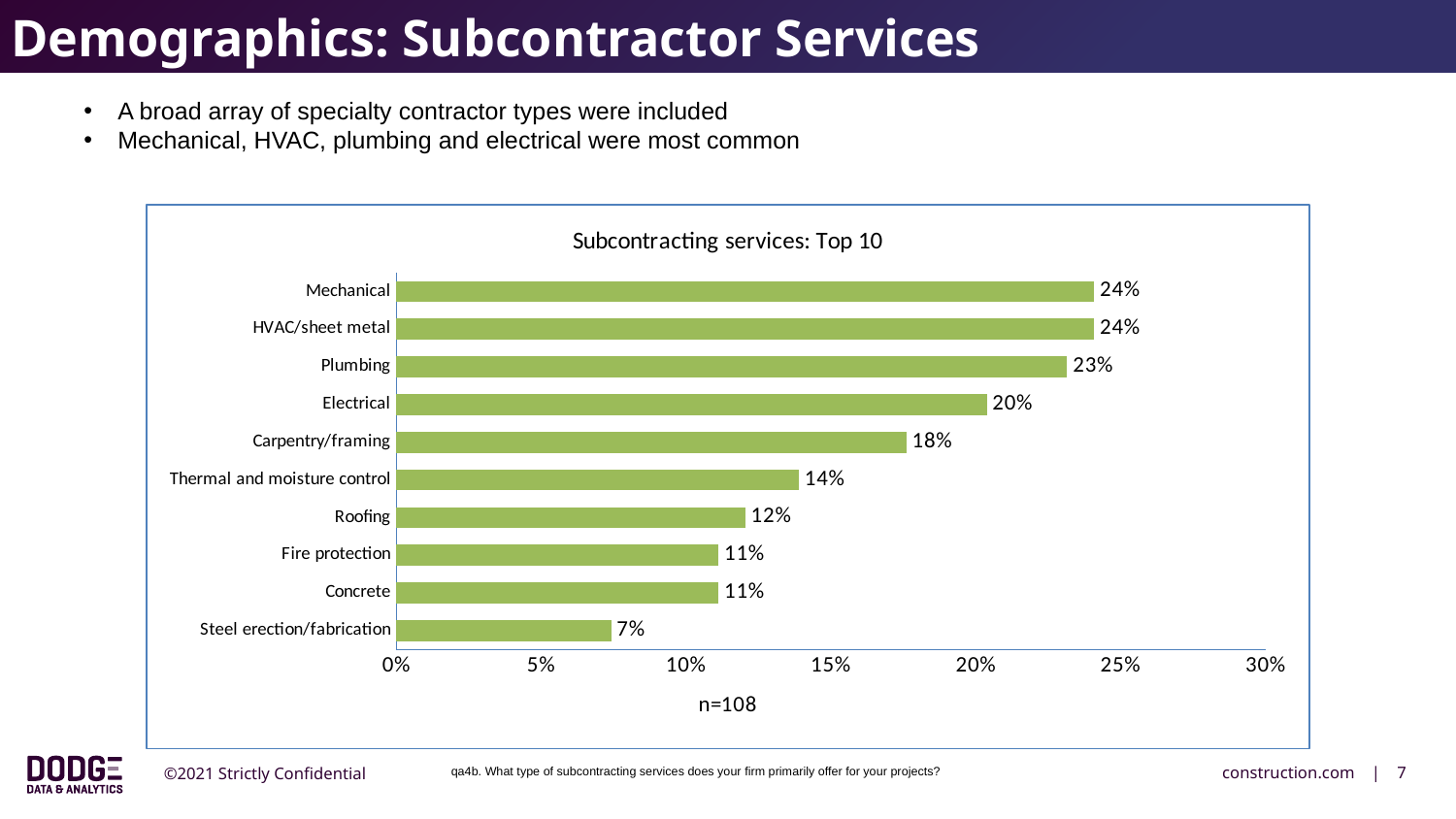
What is the value for Carpentry/framing? 18% What is the title of the chart? Subcontracting services: Top 10 Which is larger, the value for Plumbing or the value for Electrical? Plumbing What is the value for Plumbing? 23% What kind of chart is shown on the slide? Bar chart What is the difference between the values for Mechanical and Steel erection/fabrication? 17% How many categories are shown in the chart? 10 What is the difference between the values for Electrical and Roofing? 8% Which category has the lowest value? Steel erection/fabrication What sample size (n) is shown below the chart? n=108 Which is larger, the value for Roofing or the value for Carpentry/framing? Carpentry/framing What is the value for Thermal and moisture control? 14%